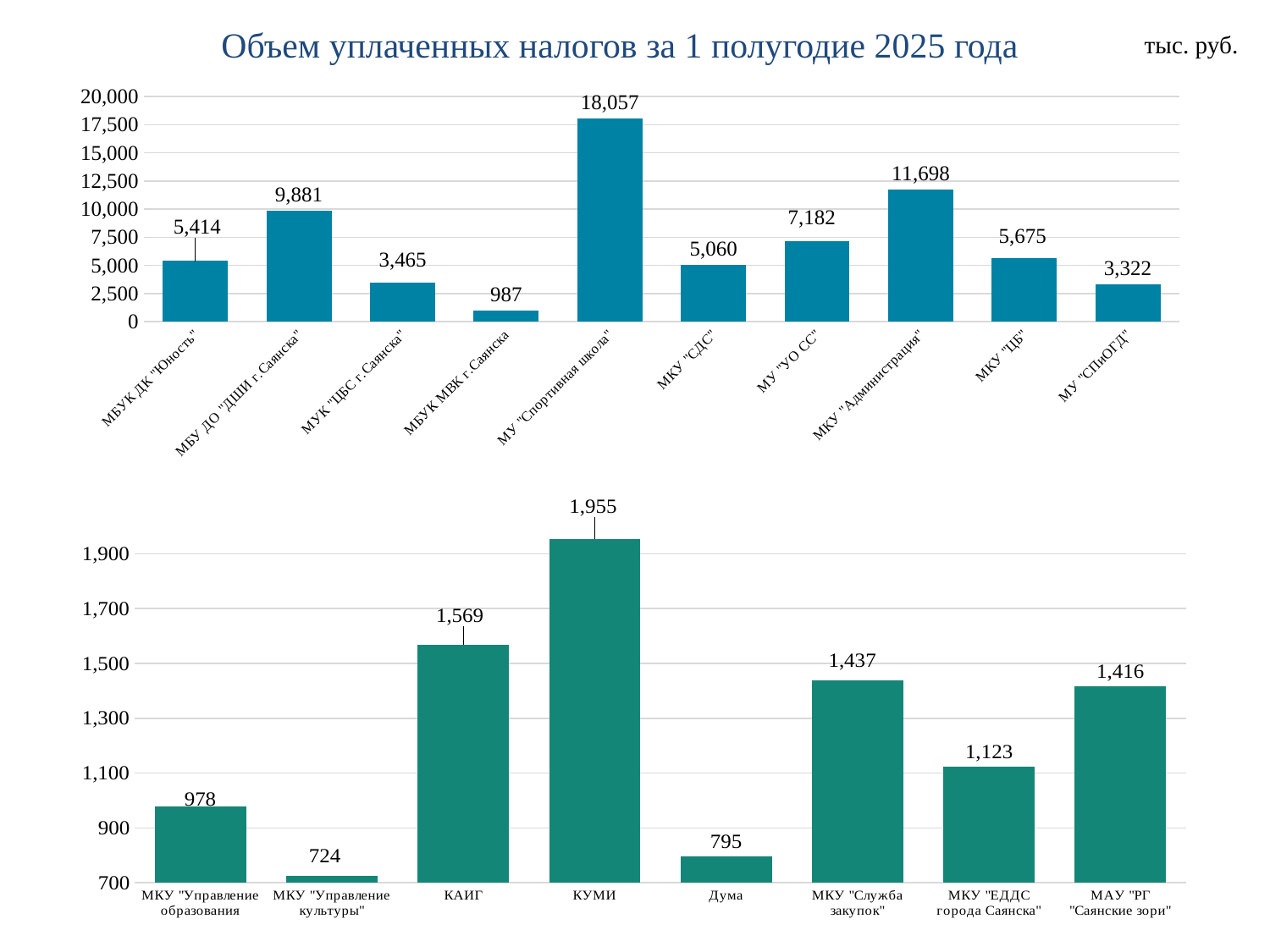
In the bottom chart, which category has the highest value? КУМИ What type of chart is the bottom chart? Bar chart What is the title of the top chart? Объем уплаченных налогов за 1 полугодие 2025 года In the top chart, which category has the lowest value? МБУК МВК г.Саянска In the top chart, what is the value for МУ "Спортивная школа"? 18,057 In the top chart, what is the difference between МКУ "Администрация" and МУ "УО СС"? 4,516 In the bottom chart, what is the difference between МКУ "Служба закупок" and МАУ "РГ "Саянские зори"? 21 In the bottom chart, what is the value for КАИГ? 1,569 In the bottom chart, which category has the lowest value? МКУ "Управление культуры" How many categories are shown in the bottom chart? 8 How many categories are shown in the top chart? 10 In the top chart, which is larger: МКУ "ЦБ" or МКУ "СДС"? МКУ "ЦБ"